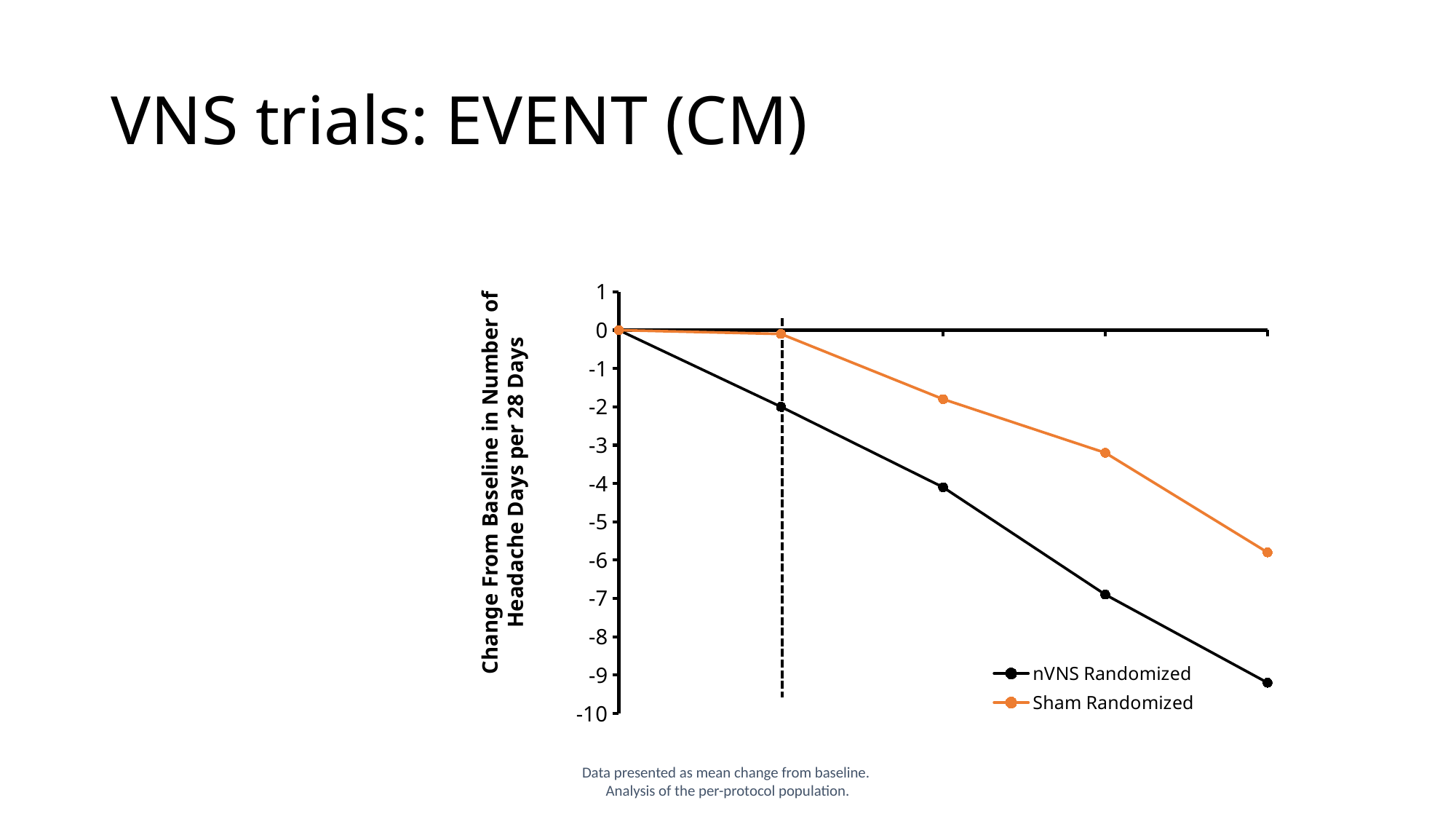
At the final point, which series has the larger value, nVNS Randomized or Sham Randomized? Sham Randomized What are the two series named in the legend? nVNS Randomized and Sham Randomized What kind of chart is shown on the slide? line chart Do the values for the nVNS Randomized series rise or fall along the x axis? fall How many data points are plotted for the nVNS Randomized series? 5 What is the y-axis title of the chart? Change From Baseline in Number of Headache Days per 28 Days Is the final value for the nVNS Randomized series greater or less than -8? less Do the values for the Sham Randomized series rise or fall along the x axis? fall Is the final value for the Sham Randomized series greater or less than -5? less Which series reaches the lowest value at the final point? nVNS Randomized What is the value of both series at the first point on the x axis? 0 How many series does the legend list? 2